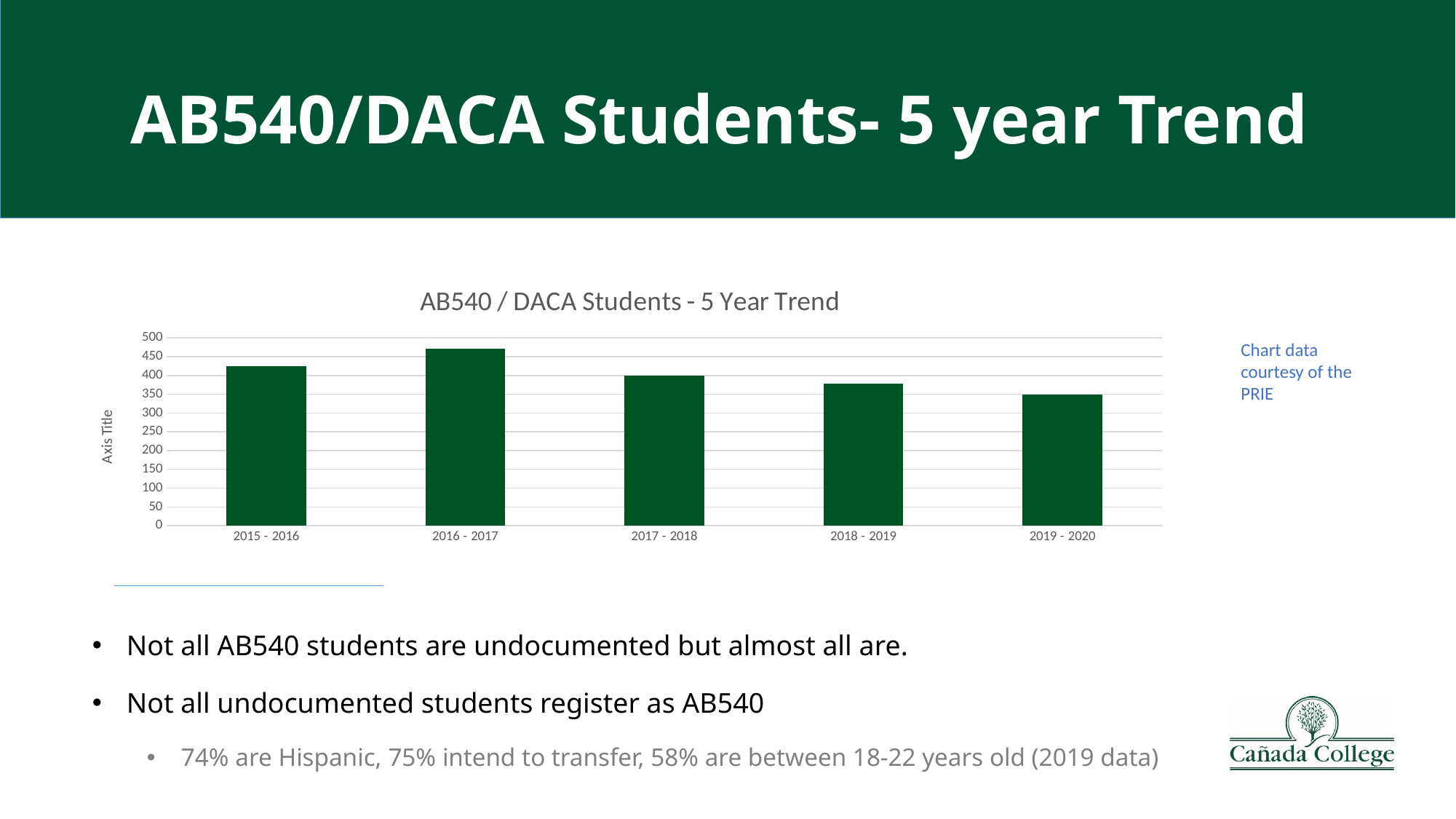
From 2016 - 2017 to 2019 - 2020, do the values rise or fall? fall What kind of chart is shown on the slide? bar chart Is the value for 2016 - 2017 greater or less than 450? greater Which is larger, the value for 2015 - 2016 or the value for 2017 - 2018? 2015 - 2016 How many academic years are shown on the x axis of the chart? 5 Is the value for 2018 - 2019 greater or less than 400? less Is the value for 2019 - 2020 greater or less than 400? less Which academic year has the highest number of AB540/DACA students? 2016 - 2017 What is the title of the chart? AB540 / DACA Students - 5 Year Trend Which academic year has the lowest number of AB540/DACA students? 2019 - 2020 Which is larger, the value for 2016 - 2017 or the value for 2018 - 2019? 2016 - 2017